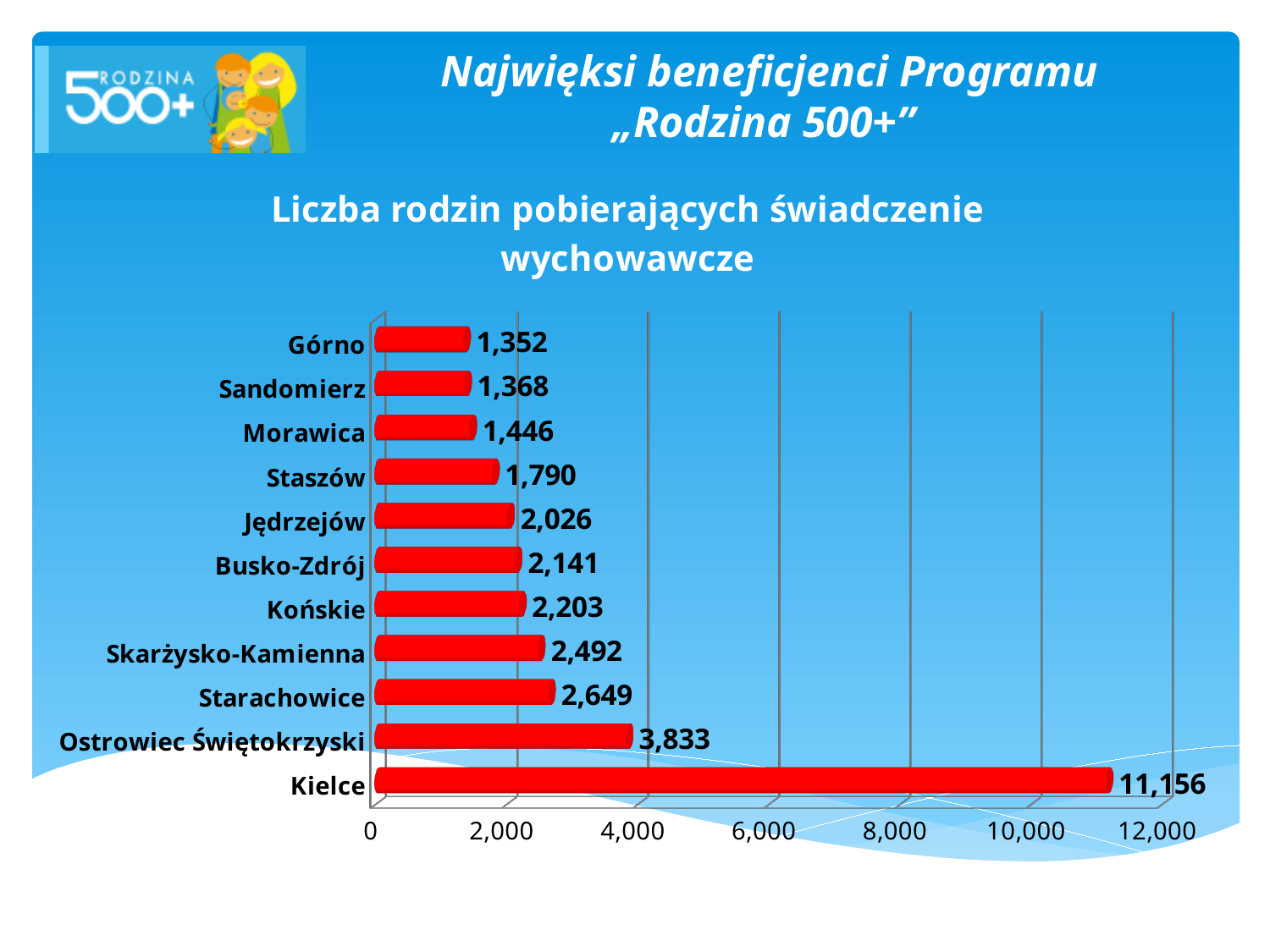
Which category has the lowest value? Górno What is the difference between the values for Kielce and Ostrowiec Świętokrzyski? 7,323 What is the value for Ostrowiec Świętokrzyski? 3,833 What is the difference between the values for Starachowice and Skarżysko-Kamienna? 157 Is the value for Ostrowiec Świętokrzyski greater or less than 4,000? less What kind of chart is shown on the slide? bar chart How many categories are shown in the chart? 11 What is the title of the chart? Liczba rodzin pobierających świadczenie wychowawcze What is the value for Kielce? 11,156 Which is larger, the value for Końskie or the value for Jędrzejów? Końskie Which category has the highest value? Kielce What is the value for Busko-Zdrój? 2,141